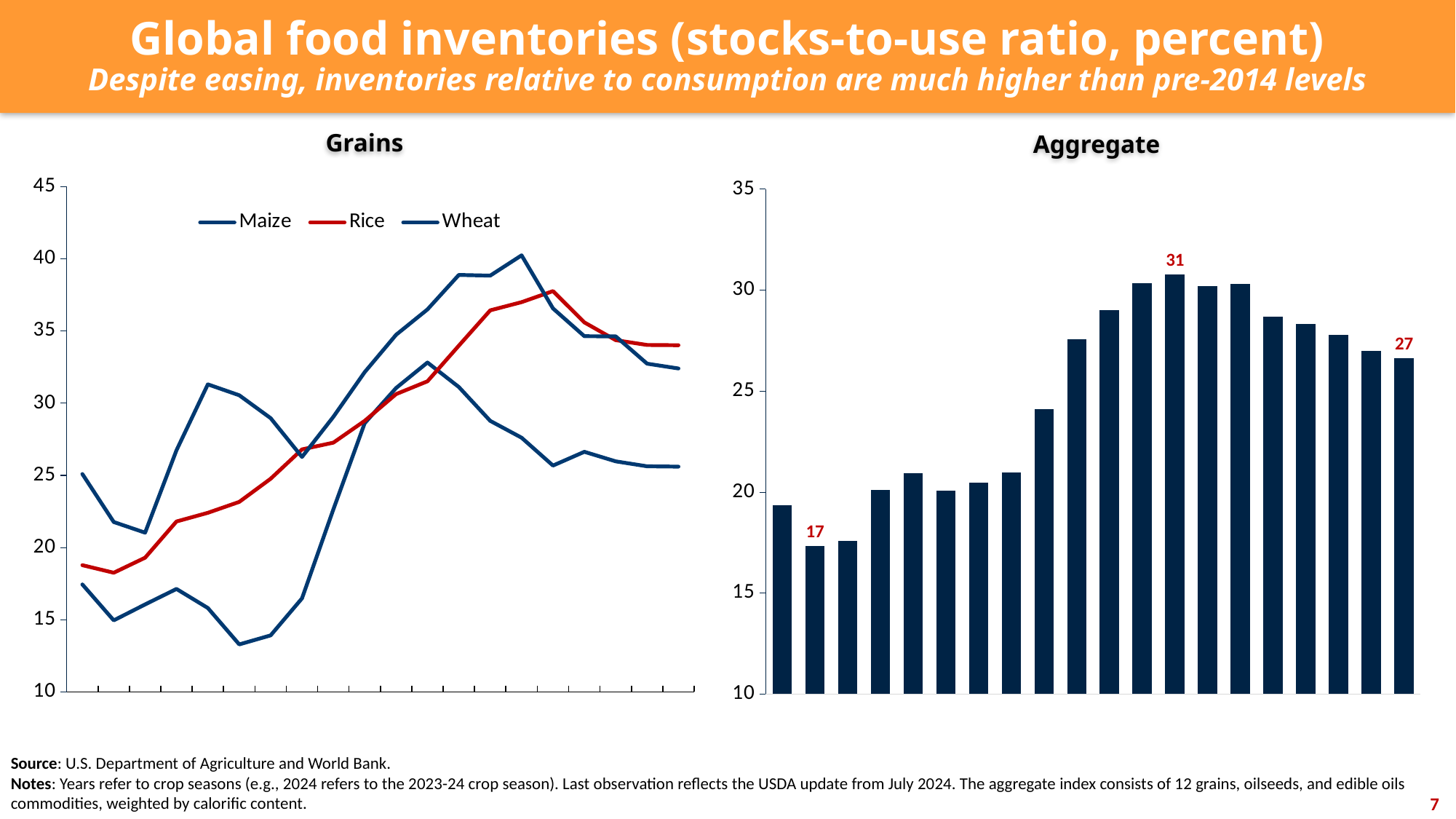
In the Aggregate chart, what is the highest labeled value? 31 In the Aggregate chart, is the value of the ninth bar from the left greater or less than 20? greater What kind of chart is the Aggregate chart? bar chart In the Grains chart, is the last value of the Rice series greater or less than 30? greater What kind of chart is the Grains chart? line chart How many bars are plotted in the Aggregate chart? 20 How many series does the legend of the Grains chart list? 3 In the Aggregate chart, what value is labeled on the rightmost bar? 27 In the Aggregate chart, what is the difference between the highest labeled value (31) and the lowest labeled value (17)? 14 In the Aggregate chart, what is the lowest labeled value? 17 In the Grains chart, does the Rice series overall rise or fall from left to right? rise In the Grains chart, which series is drawn in red? Rice